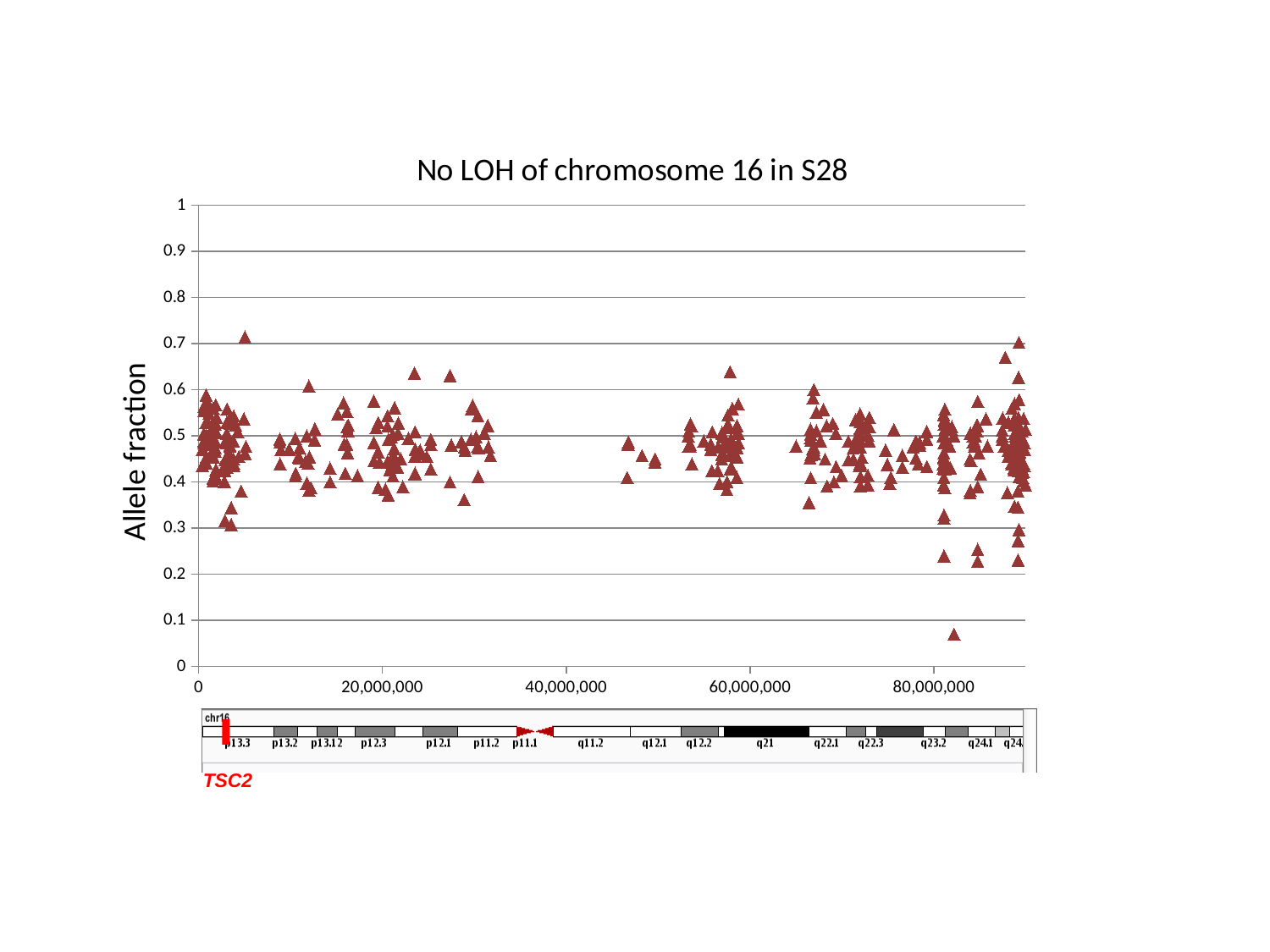
Is the lowest plotted allele fraction value greater or less than 0.1? less Do the allele fraction values show a clear rising or falling trend along the x axis? no, they stay roughly flat around 0.5 Is the highest plotted allele fraction value greater or less than 0.6? greater Is the lowest point plotted near position 82,000,000 greater or less than 0.1? less What is the label on the y axis of the chart? Allele fraction What is the title of the chart? No LOH of chromosome 16 in S28 What is the highest tick value shown on the y axis? 1 What kind of chart is shown on the slide? scatter plot What is the largest tick value labelled on the x axis? 80,000,000